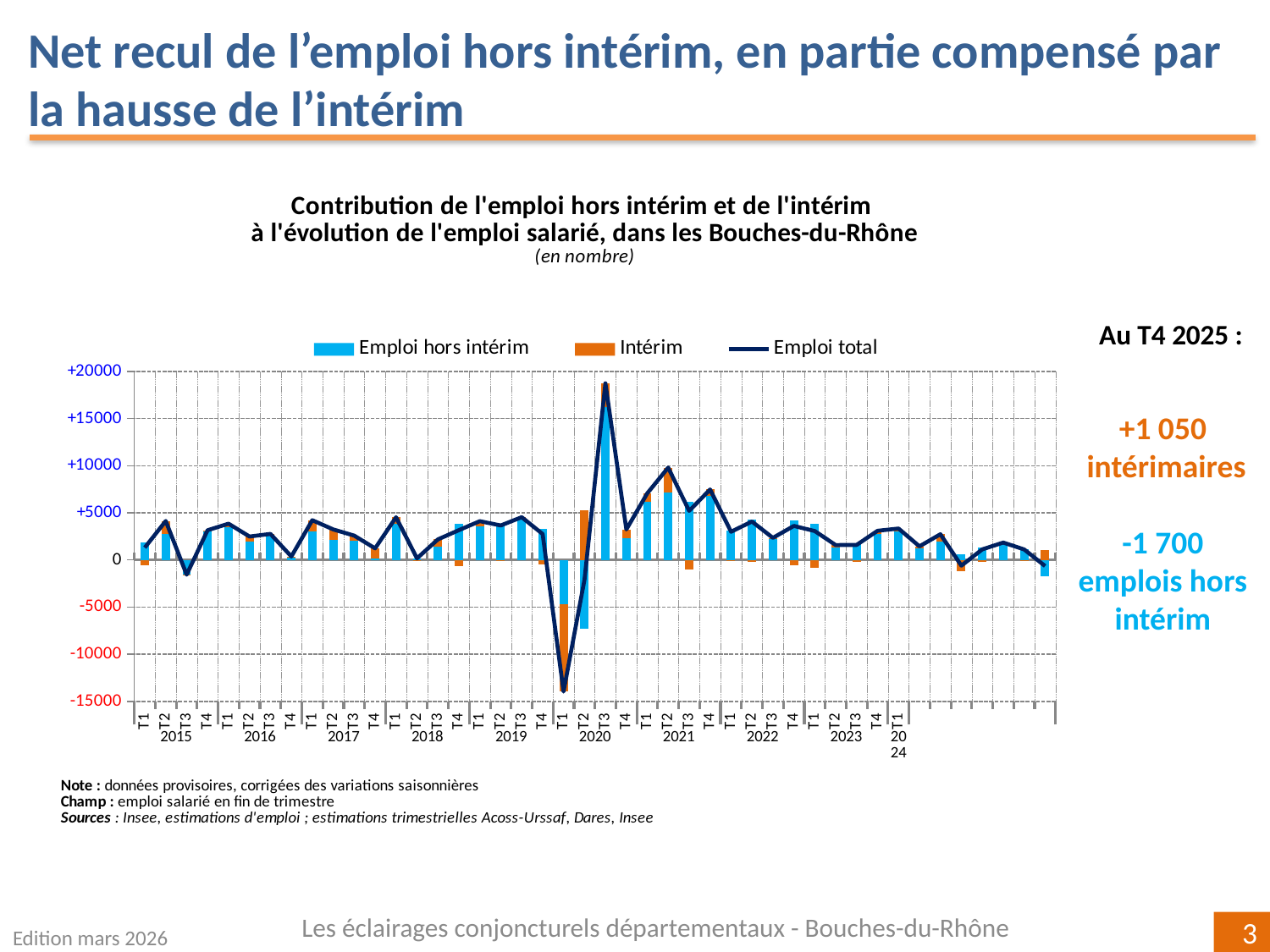
How many series does the chart legend list? 3 According to the slide, what is the contribution of Intérim at T4 2025? +1 050 What are the three series listed in the chart legend? Emploi hors intérim, Intérim, Emploi total Is the Emploi hors intérim bar at T2 2021 greater or less than +5000? greater Which series is drawn as a dark navy line on the chart? Emploi total Which is larger, the Emploi hors intérim bar at T3 2020 or at T2 2021? T3 2020 Is the value of Emploi total at T3 2020 greater or less than +15000? greater In which quarter does the Emploi total line reach its highest value? T3 2020 Is the value of Emploi total at T1 2020 greater or less than -10000? less What kind of chart is shown on the slide? A combined bar and line chart In which quarter does the Emploi total line reach its lowest value? T1 2020 According to the slide, what is the contribution of Emploi hors intérim at T4 2025? -1 700